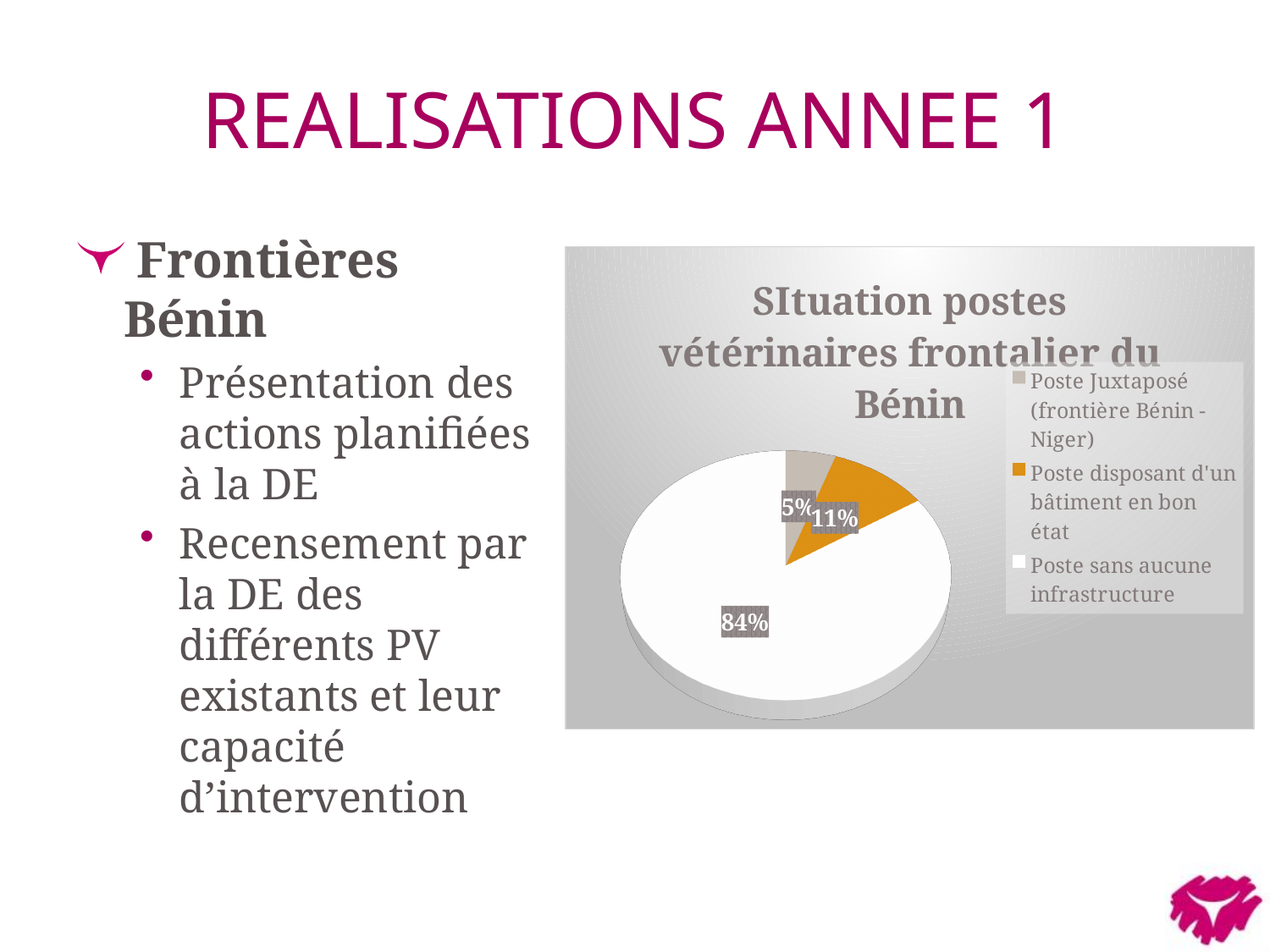
What share of the pie is labelled 'Poste Juxtaposé (frontière Bénin - Niger)'? 5% What is the difference in percentage points between 'Poste sans aucune infrastructure' and 'Poste disposant d'un bâtiment en bon état'? 73 Which category has the smallest slice of the pie? Poste Juxtaposé (frontière Bénin - Niger) What kind of chart is shown on the slide? Pie chart What share of the pie is labelled 'Poste sans aucune infrastructure'? 84% Which is larger: the slice for 'Poste disposant d'un bâtiment en bon état' or the slice for 'Poste Juxtaposé (frontière Bénin - Niger)'? Poste disposant d'un bâtiment en bon état What is the difference in percentage points between 'Poste disposant d'un bâtiment en bon état' and 'Poste Juxtaposé (frontière Bénin - Niger)'? 6 Which category has the largest slice of the pie? Poste sans aucune infrastructure What colour is the slice for 'Poste disposant d'un bâtiment en bon état'? Orange What share of the pie is labelled 'Poste disposant d'un bâtiment en bon état'? 11% How many slices does the pie chart have? 3 What is the title of the pie chart? SItuation postes vétérinaires frontalier du Bénin